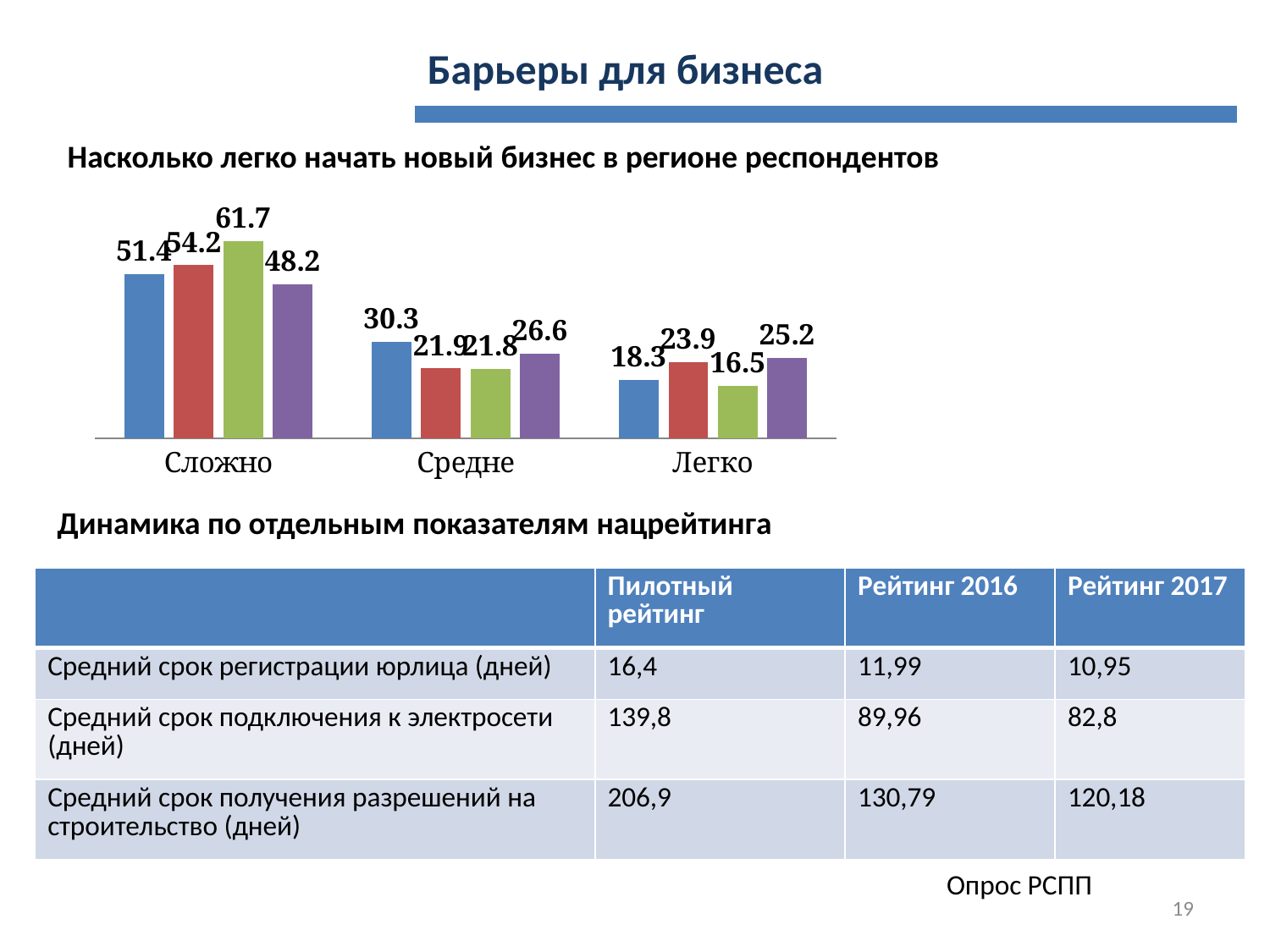
What type of chart is shown under the heading "Насколько легко начать новый бизнес в регионе респондентов"? Bar chart Do the blue bar values rise or fall moving from "Сложно" to "Легко" along the x axis? Fall For the category "Легко", which is larger: the red bar or the green bar? The red bar What is the value of the green bar for the category "Сложно"? 61.7 How many categories are shown on the x axis of the bar chart? 3 Which category has the highest value for the green bars? Сложно What is the value of the purple bar for the category "Легко"? 25.2 How many bars are shown for each category in the bar chart? 4 Which category has the lowest value for the blue bars? Легко What is the value of the blue bar for the category "Сложно"? 51.4 What is the value of the red bar for the category "Средне"? 21.9 What is the difference between the green bar and the blue bar for the category "Сложно"? 10.3